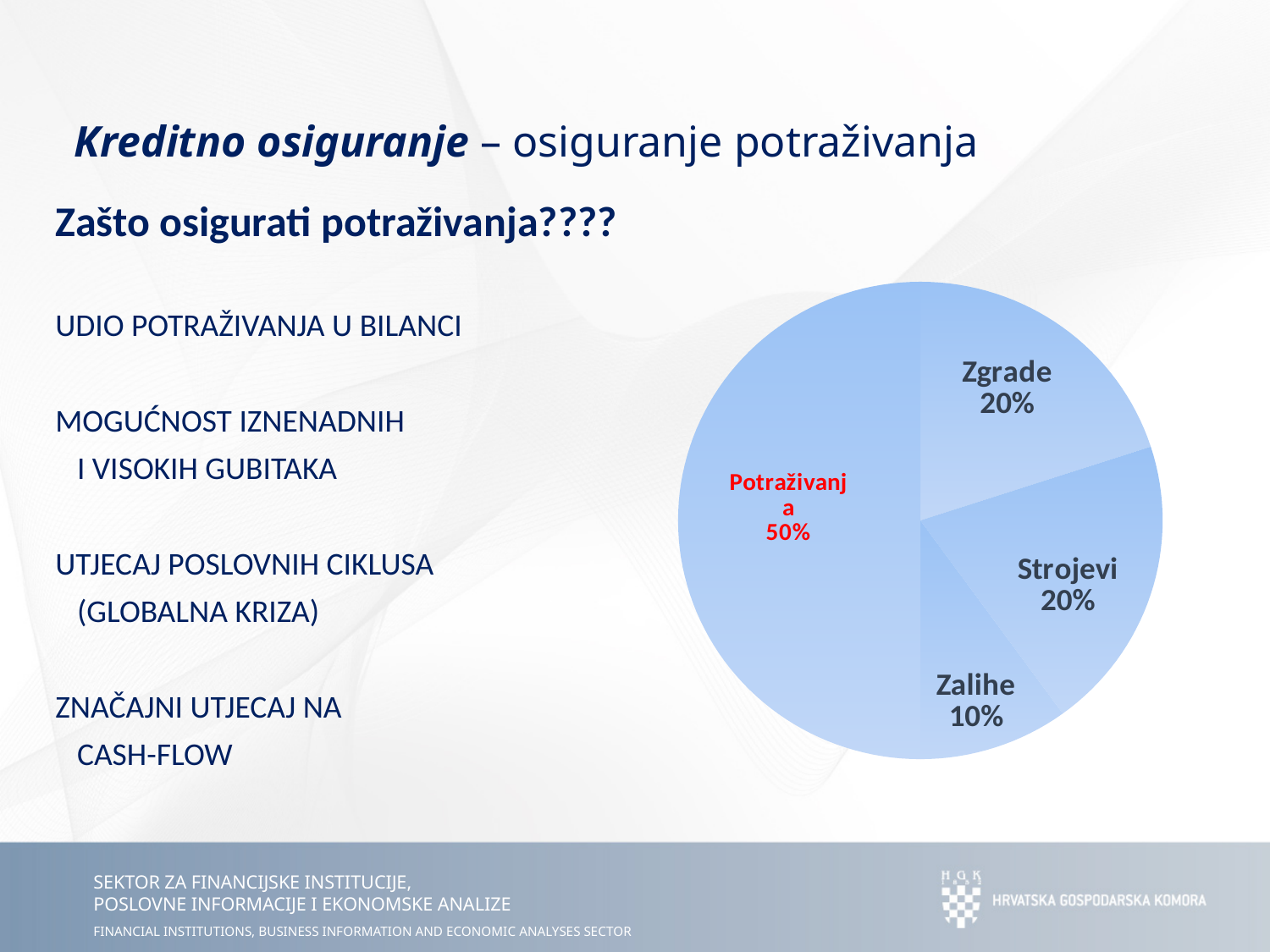
What share of the pie does Strojevi have? 20% What is the difference between the Potraživanja share and the Zalihe share? 40% How many slices does the pie chart have? 4 Which is larger, the Strojevi slice or the Zalihe slice? Strojevi What share of the pie does Potraživanja have? 50% What share of the pie does Zalihe have? 10% What share of the pie does Zgrade have? 20% What kind of chart is shown on the slide? pie chart What is the combined share of Zgrade and Strojevi? 40% Which slice label is printed in red on the pie chart? Potraživanja Which slice of the pie is the largest? Potraživanja Which slice of the pie is the smallest? Zalihe